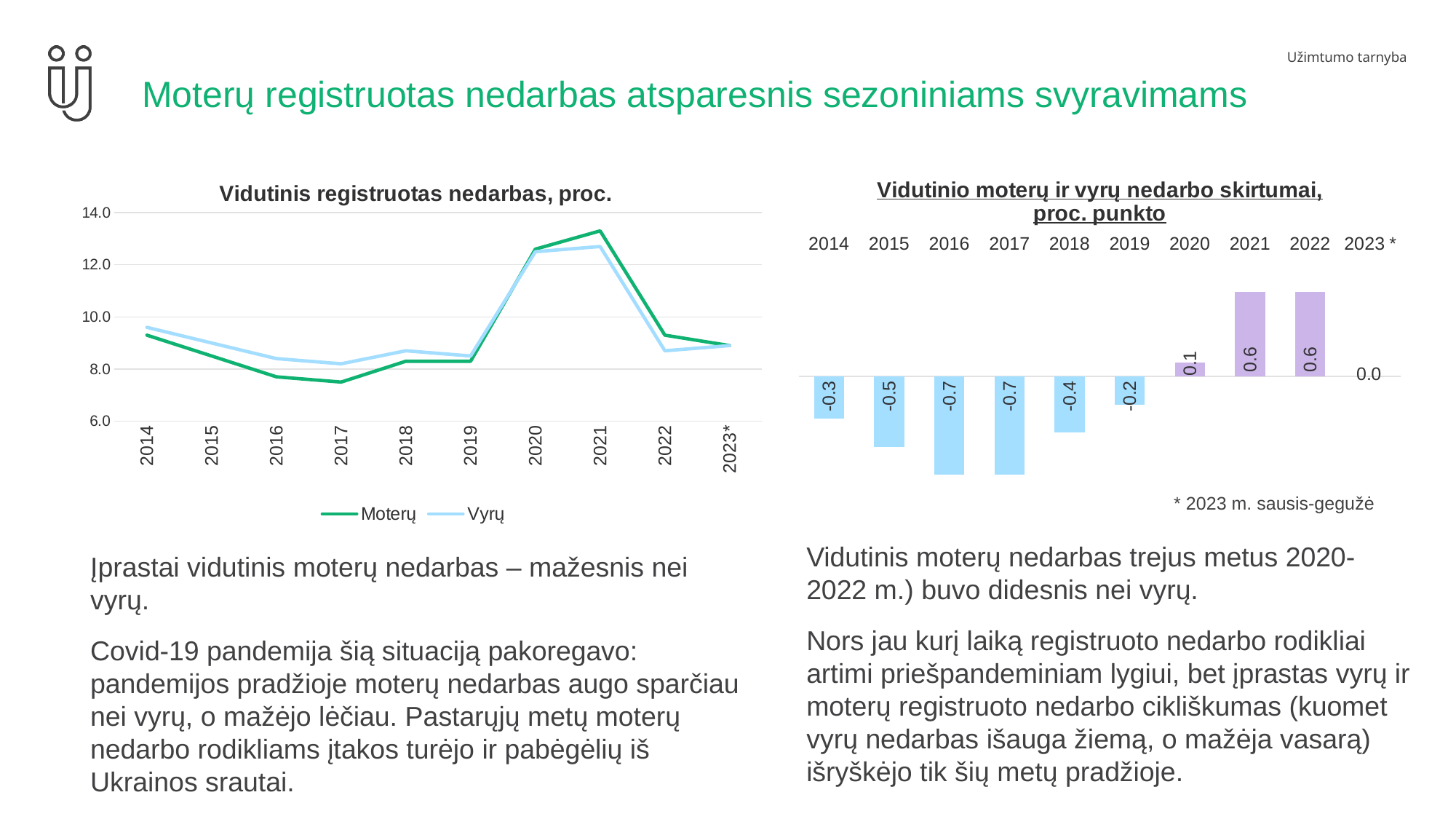
In the chart "Vidutinio moterų ir vyrų nedarbo skirtumai, proc. punkto", what is the difference between the values for 2021 and 2014? 0.9 In the chart "Vidutinis registruotas nedarbas, proc.", do the values rise or fall from 2021 to 2022? fall In the chart "Vidutinio moterų ir vyrų nedarbo skirtumai, proc. punkto", what is the value for 2023*? 0.0 In the chart "Vidutinio moterų ir vyrų nedarbo skirtumai, proc. punkto", what is the value for 2016? -0.7 What kind of chart is the chart titled "Vidutinis registruotas nedarbas, proc."? line chart What kind of chart is the chart titled "Vidutinio moterų ir vyrų nedarbo skirtumai, proc. punkto"? bar chart In the chart "Vidutinis registruotas nedarbas, proc.", is the Moterų value for 2017 greater or less than 8.0? less How many years are shown in the chart "Vidutinio moterų ir vyrų nedarbo skirtumai, proc. punkto"? 10 In the chart "Vidutinio moterų ir vyrų nedarbo skirtumai, proc. punkto", what is the value for 2020? 0.1 In the chart "Vidutinis registruotas nedarbas, proc.", is the Moterų value for 2021 greater or less than 12.0? greater How many series does the legend of the chart "Vidutinis registruotas nedarbas, proc." list? 2 In the chart "Vidutinis registruotas nedarbas, proc.", which series is higher in 2017, Moterų or Vyrų? Vyrų